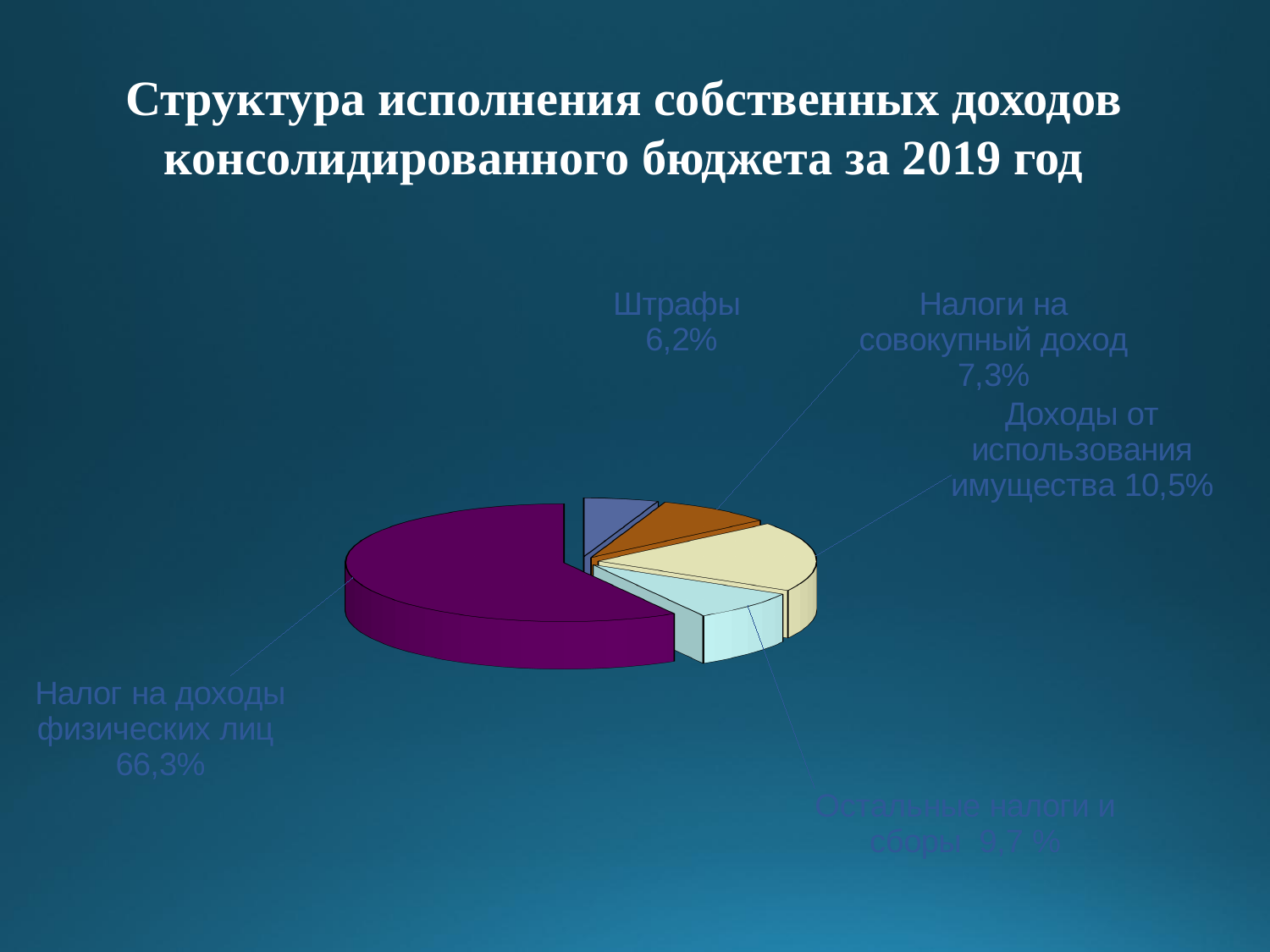
Which category has the smallest slice of the pie? Штрафы What is the difference in percentage points between Налоги на совокупный доход and Штрафы? 1,1 Which category has the largest slice of the pie? Налог на доходы физических лиц Which is larger, Доходы от использования имущества or Налоги на совокупный доход? Доходы от использования имущества What share of the pie does Налог на доходы физических лиц have? 66,3% What is the value shown for Доходы от использования имущества? 10,5% What is the difference in percentage points between Доходы от использования имущества and Штрафы? 4,3 What is the title of the slide? Структура исполнения собственных доходов консолидированного бюджета за 2019 год How many slices does the pie chart have? 5 What is the value shown for Налоги на совокупный доход? 7,3% What kind of chart is shown on the slide? pie chart What is the value shown for Штрафы? 6,2%